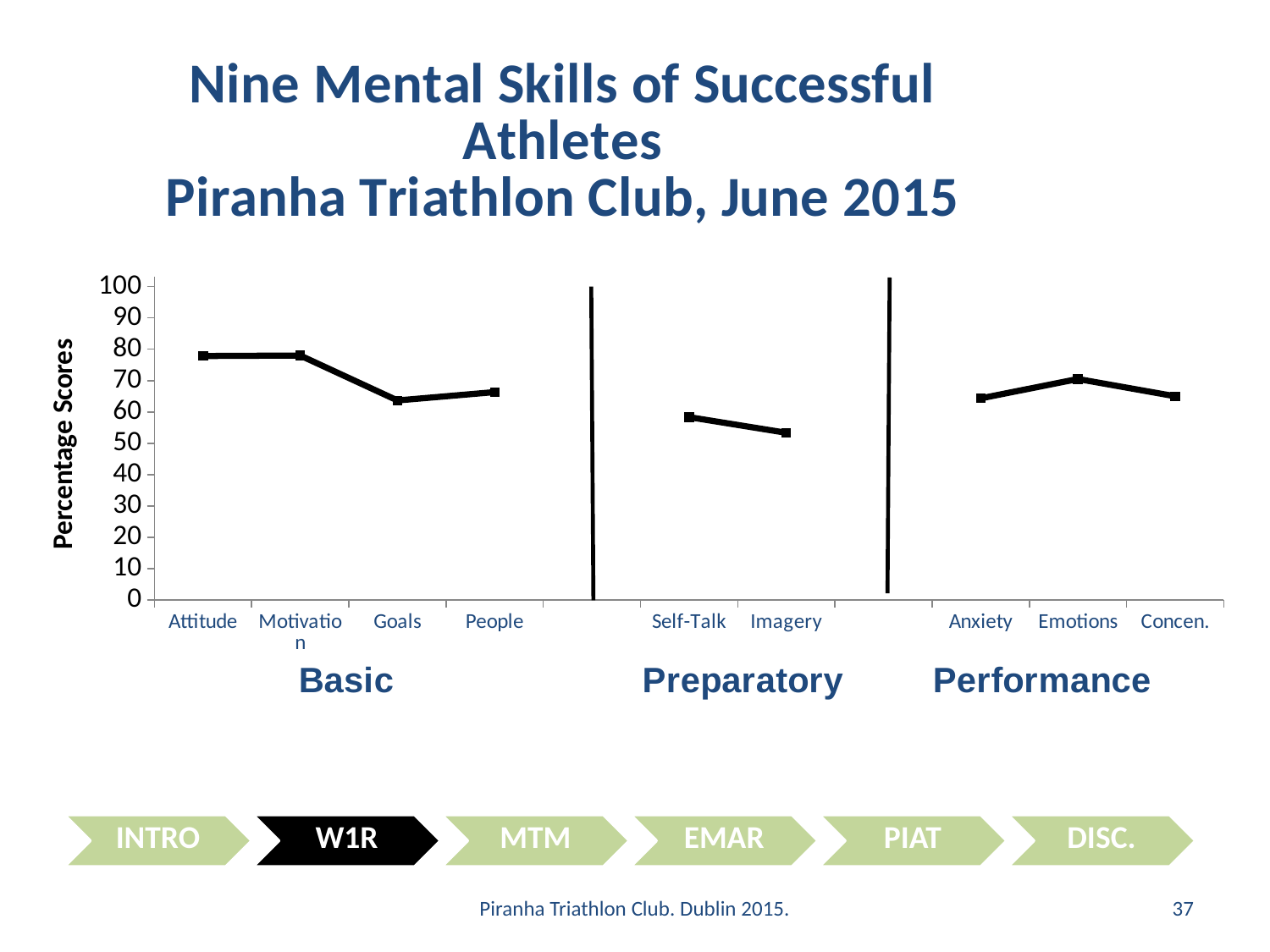
Which has the higher percentage score, Anxiety or Emotions? Emotions Does the line rise or fall from Self-Talk to Imagery? fall Is the value for Emotions greater or less than 80? less Which mental skill has the lowest percentage score? Imagery Is the value for Imagery greater or less than 60? less Is the value for Attitude greater or less than 70? greater What kind of chart is shown on the slide? line chart Which has the higher percentage score, Attitude or Goals? Attitude How many mental skills (categories) are plotted along the x axis? 9 What is the title of the vertical axis? Percentage Scores